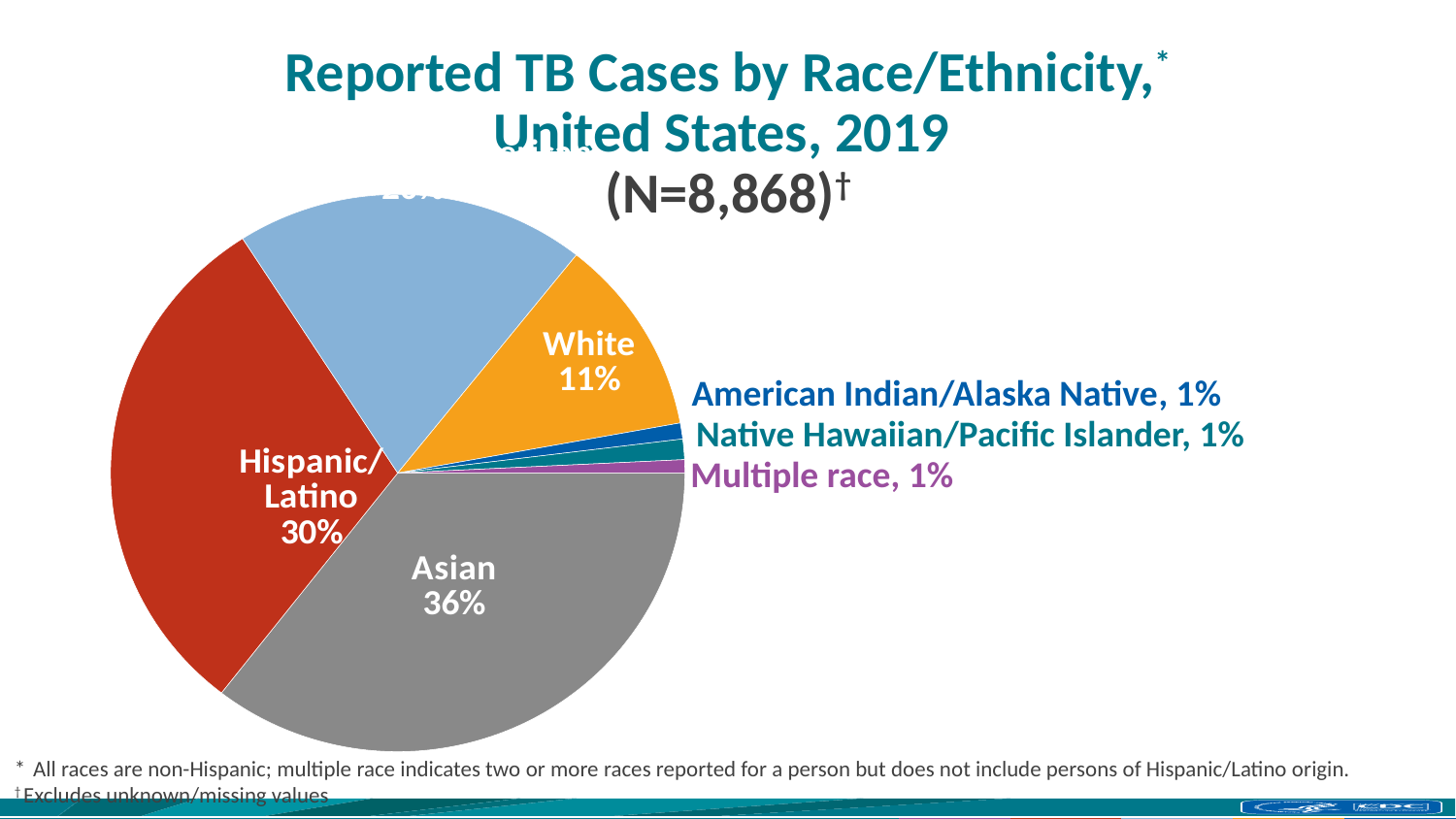
What is the total number of cases (N) given in the chart title? 8,868 What percentage of reported TB cases is shown for Hispanic/Latino persons? 30% What share of reported TB cases is attributed to Asian persons? 36% Which is larger, the share for Asian or the share for Hispanic/Latino? Asian What percentage is shown for American Indian/Alaska Native? 1% What colour is the Asian slice of the pie? gray What kind of chart is shown on the slide? pie chart What percentage is shown for Multiple race? 1% What is the difference in percentage points between the Hispanic/Latino share and the White share? 19 percentage points What percentage of reported TB cases is shown for White persons? 11% What is the difference in percentage points between the Asian share and the Hispanic/Latino share? 6 percentage points Which race/ethnicity group has the largest share of reported TB cases? Asian